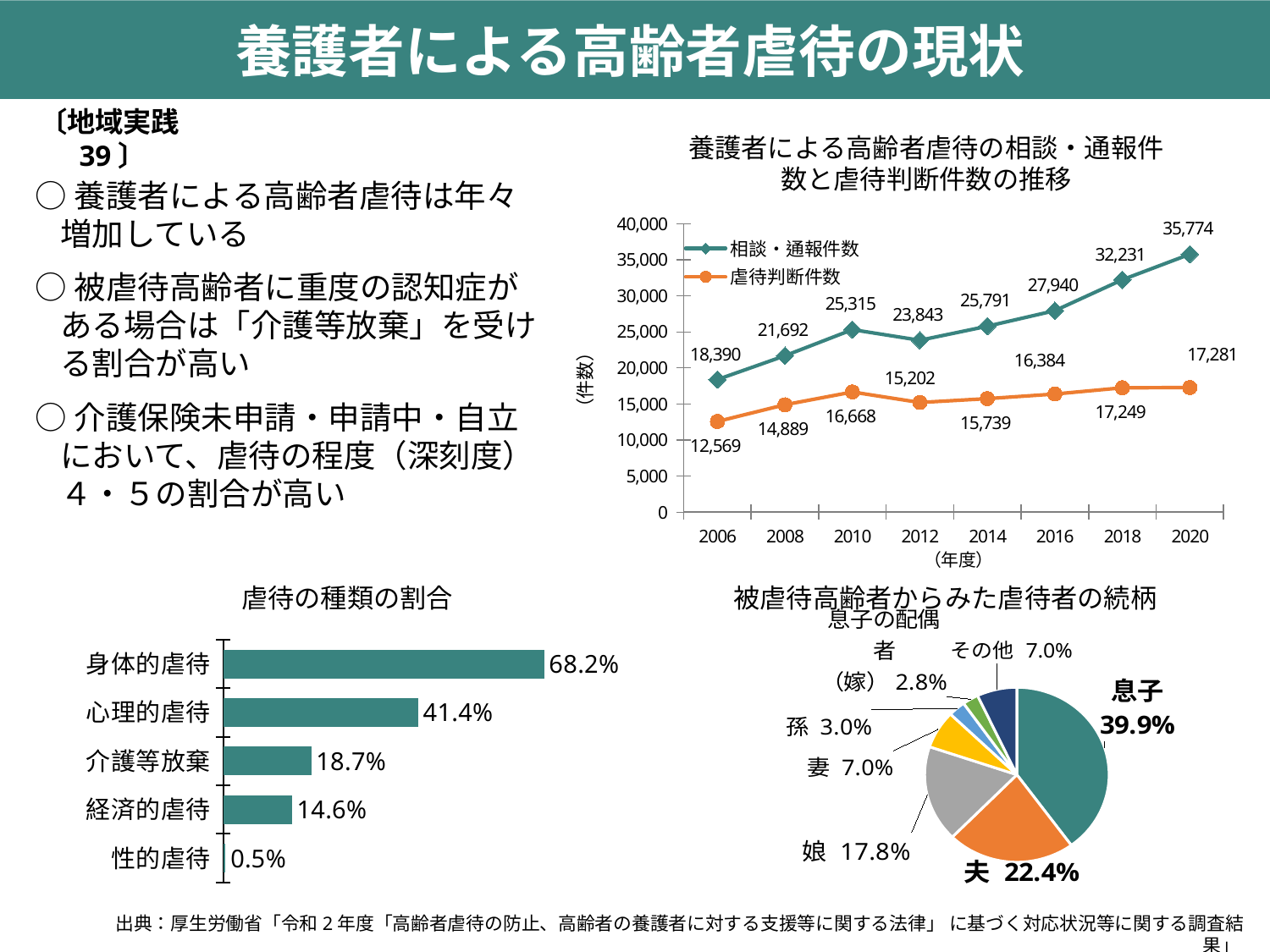
In the line chart titled 養護者による高齢者虐待の相談・通報件数と虐待判断件数の推移, in which year is 相談・通報件数 lowest? 2006 In the line chart titled 養護者による高齢者虐待の相談・通報件数と虐待判断件数の推移, does 相談・通報件数 rise or fall between 2010 and 2012? fall In the line chart titled 養護者による高齢者虐待の相談・通報件数と虐待判断件数の推移, how many years are plotted on the x axis? 8 In the line chart titled 養護者による高齢者虐待の相談・通報件数と虐待判断件数の推移, what is the value of 虐待判断件数 in 2006? 12,569 In the pie chart titled 被虐待高齢者からみた虐待者の続柄, what share does 夫 have? 22.4% In the bar chart titled 虐待の種類の割合, which category has the highest value? 身体的虐待 In the bar chart titled 虐待の種類の割合, what is the difference between 介護等放棄 and 経済的虐待? 4.1% In the bar chart titled 虐待の種類の割合, what is the value for 心理的虐待? 41.4% In the line chart titled 養護者による高齢者虐待の相談・通報件数と虐待判断件数の推移, what is the value of 相談・通報件数 in 2020? 35,774 What kind of chart is the chart titled 虐待の種類の割合? bar chart In the line chart titled 養護者による高齢者虐待の相談・通報件数と虐待判断件数の推移, what is the difference between 相談・通報件数 and 虐待判断件数 in 2020? 18,493 In the line chart titled 養護者による高齢者虐待の相談・通報件数と虐待判断件数の推移, how many series does the legend list? 2